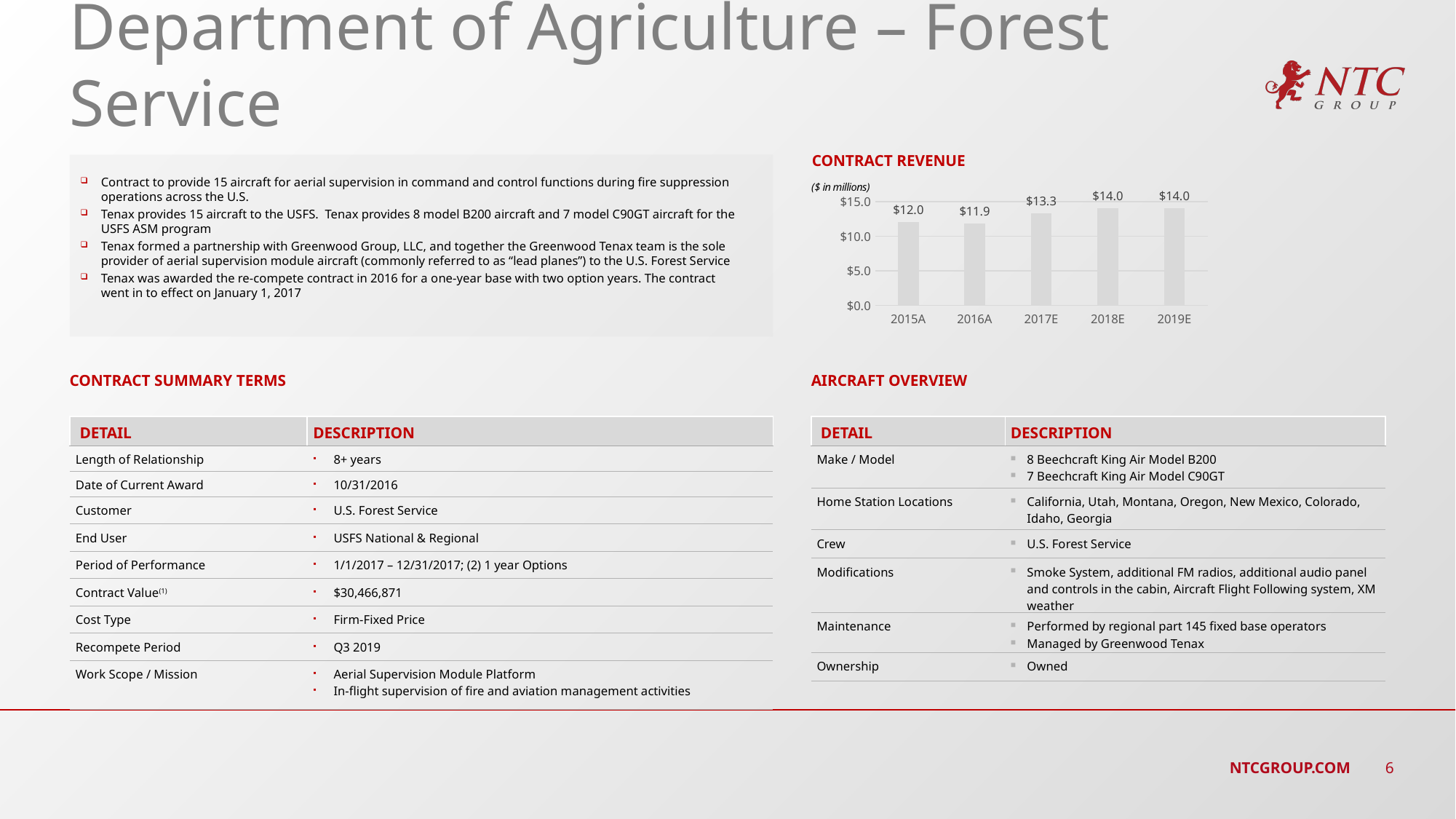
Which year has the lowest contract revenue? 2016A What kind of chart is the contract revenue chart? bar chart In what units is the contract revenue chart expressed? $ in millions What is the difference in contract revenue between 2017E and 2016A? $1.4 What is the contract revenue for 2017E? $13.3 Which is larger, the contract revenue for 2015A or 2017E? 2017E What is the contract revenue for 2019E? $14.0 Is the contract revenue for 2016A greater or less than $15.0? less What is the contract revenue for 2015A? $12.0 What is the difference in contract revenue between 2018E and 2015A? $2.0 What is the contract revenue for 2016A? $11.9 How many years are shown on the contract revenue chart? 5